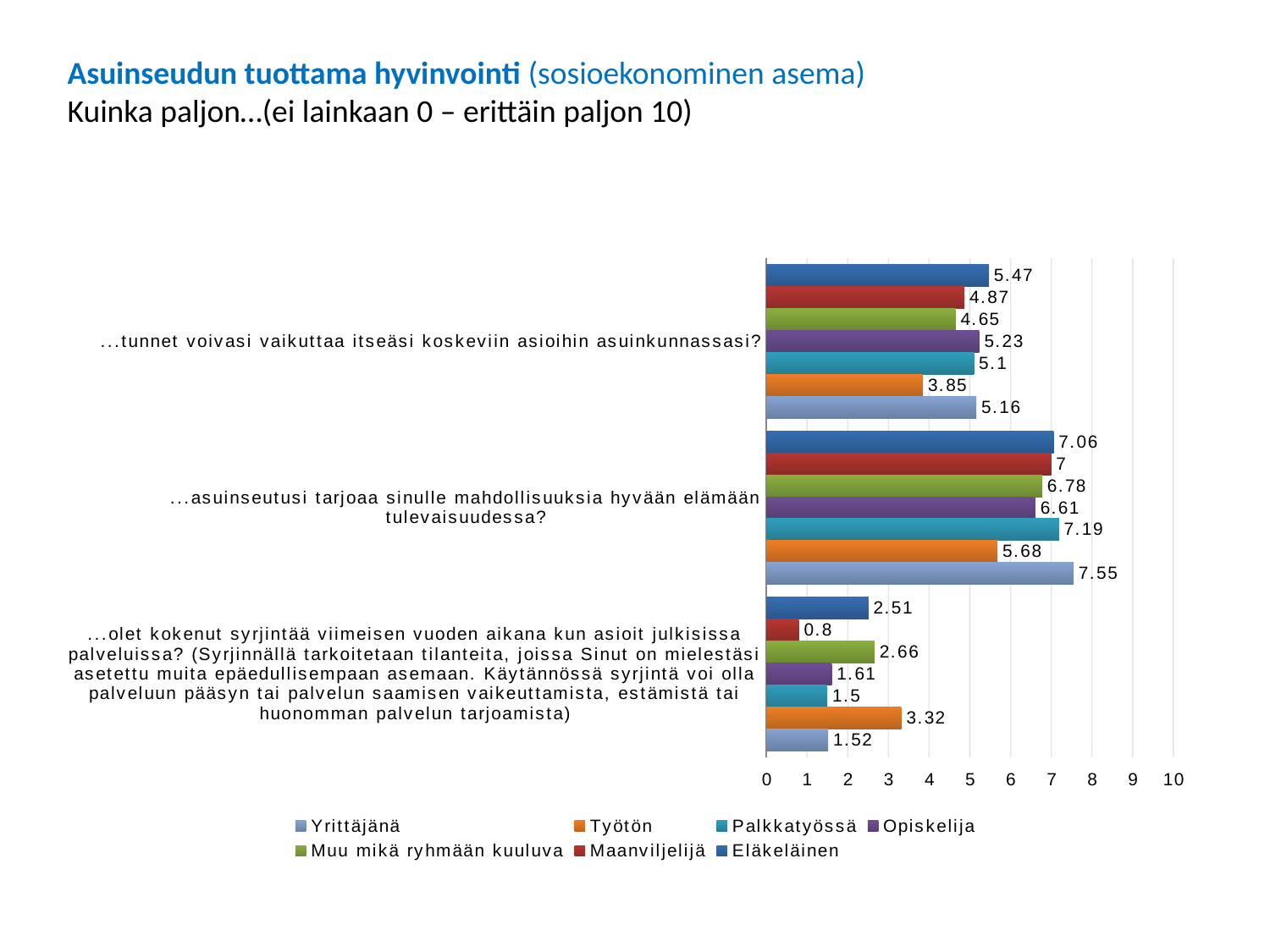
What is the maximum value shown on the horizontal axis of the chart? 10 For the question '...tunnet voivasi vaikuttaa itseäsi koskeviin asioihin asuinkunnassasi?', which is larger: the value for Eläkeläinen or the value for Muu mikä ryhmään kuuluva? Eläkeläinen How many question categories are plotted on the chart? 3 What is the value for Yrittäjänä for the question '...asuinseutusi tarjoaa sinulle mahdollisuuksia hyvään elämään tulevaisuudessa?' 7.55 Which series has the highest value for the question about experiencing discrimination ('...olet kokenut syrjintää...')? Työtön What is the value for Maanviljelijä for the question about experiencing discrimination in public services ('...olet kokenut syrjintää...')? 0.8 How many series does the legend list? 7 What kind of chart is shown on the slide? bar chart What is the difference between the Yrittäjänä and Työtön values for the question '...asuinseutusi tarjoaa sinulle mahdollisuuksia hyvään elämään tulevaisuudessa?' 1.87 What is the value for Työtön for the question '...tunnet voivasi vaikuttaa itseäsi koskeviin asioihin asuinkunnassasi?' 3.85 Which series has the lowest value for the question '...tunnet voivasi vaikuttaa itseäsi koskeviin asioihin asuinkunnassasi?' Työtön Which series has the highest value for the question '...asuinseutusi tarjoaa sinulle mahdollisuuksia hyvään elämään tulevaisuudessa?' Yrittäjänä